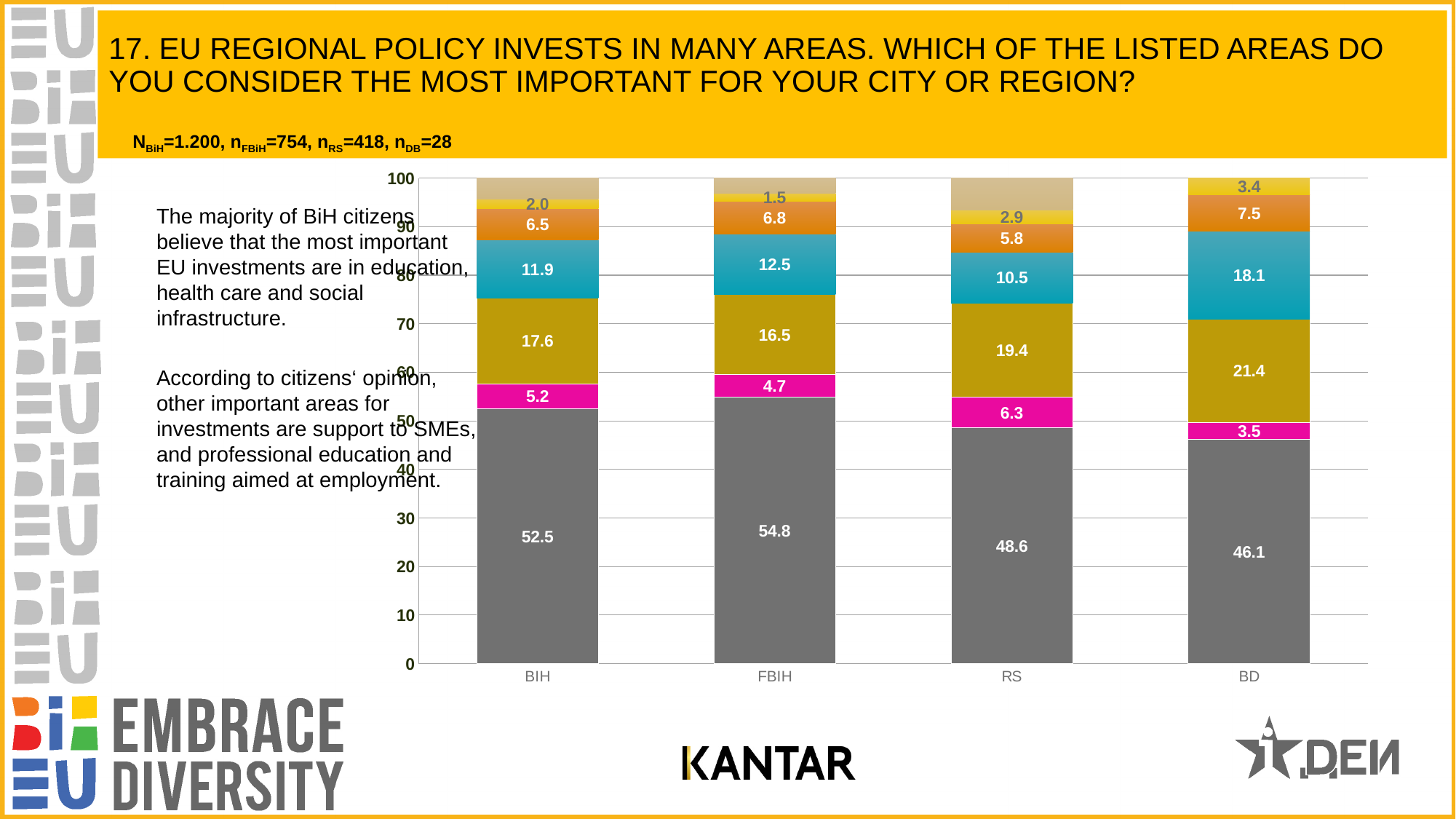
What is the difference between the grey bottom segment values for FBIH and BIH? 2.3 Which is larger, the gold segment for BD or the gold segment for RS? BD Which category has the highest value for the grey bottom segment? FBIH What are the category labels shown along the x axis, from left to right? BIH, FBIH, RS, BD What is the value of the grey bottom segment for BD? 46.1 Which category has the highest value for the teal segment? BD What kind of chart is shown on the slide? Stacked bar chart What is the value of the gold segment for RS? 19.4 What is the value of the magenta segment for FBIH? 4.7 How many categories are shown along the x axis of the chart? 4 What is the value of the grey bottom segment for BIH? 52.5 Which category has the lowest value for the grey bottom segment? BD